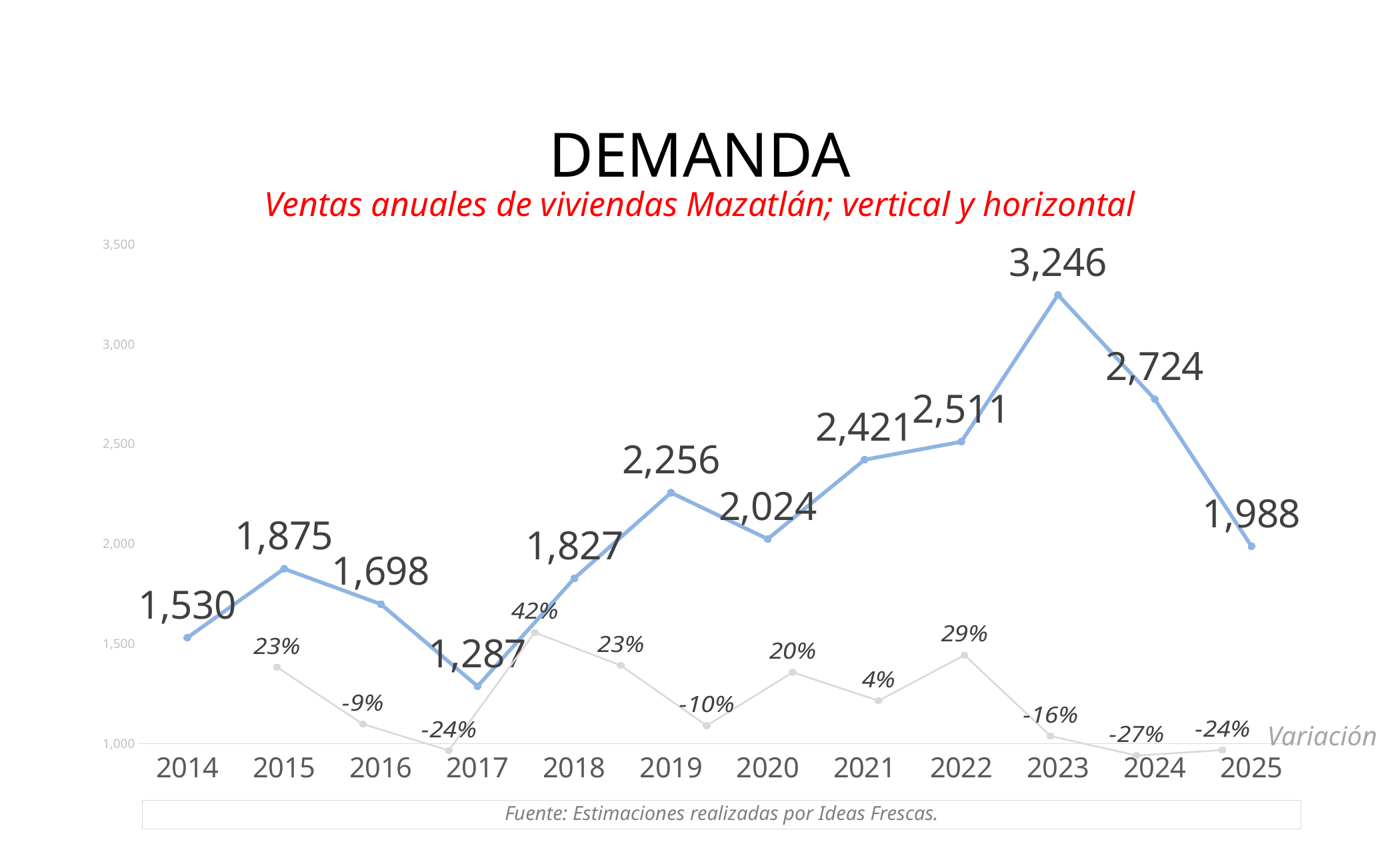
What is the highest variation percentage shown on the grey line? 42% What value is shown for 2017? 1,287 What were the annual housing sales in Mazatlán in 2023? 3,246 What kind of chart is this? line chart Do the sales rise or fall from 2023 to 2025? fall What is the difference between the sales in 2015 and 2014? 345 Which year has the lowest annual housing sales? 2017 Which year had higher sales, 2019 or 2020? 2019 Which year has the highest annual housing sales? 2023 What is the difference between the sales in 2023 and 2024? 522 What value is shown for 2025? 1,988 How many years are shown on the x axis? 12